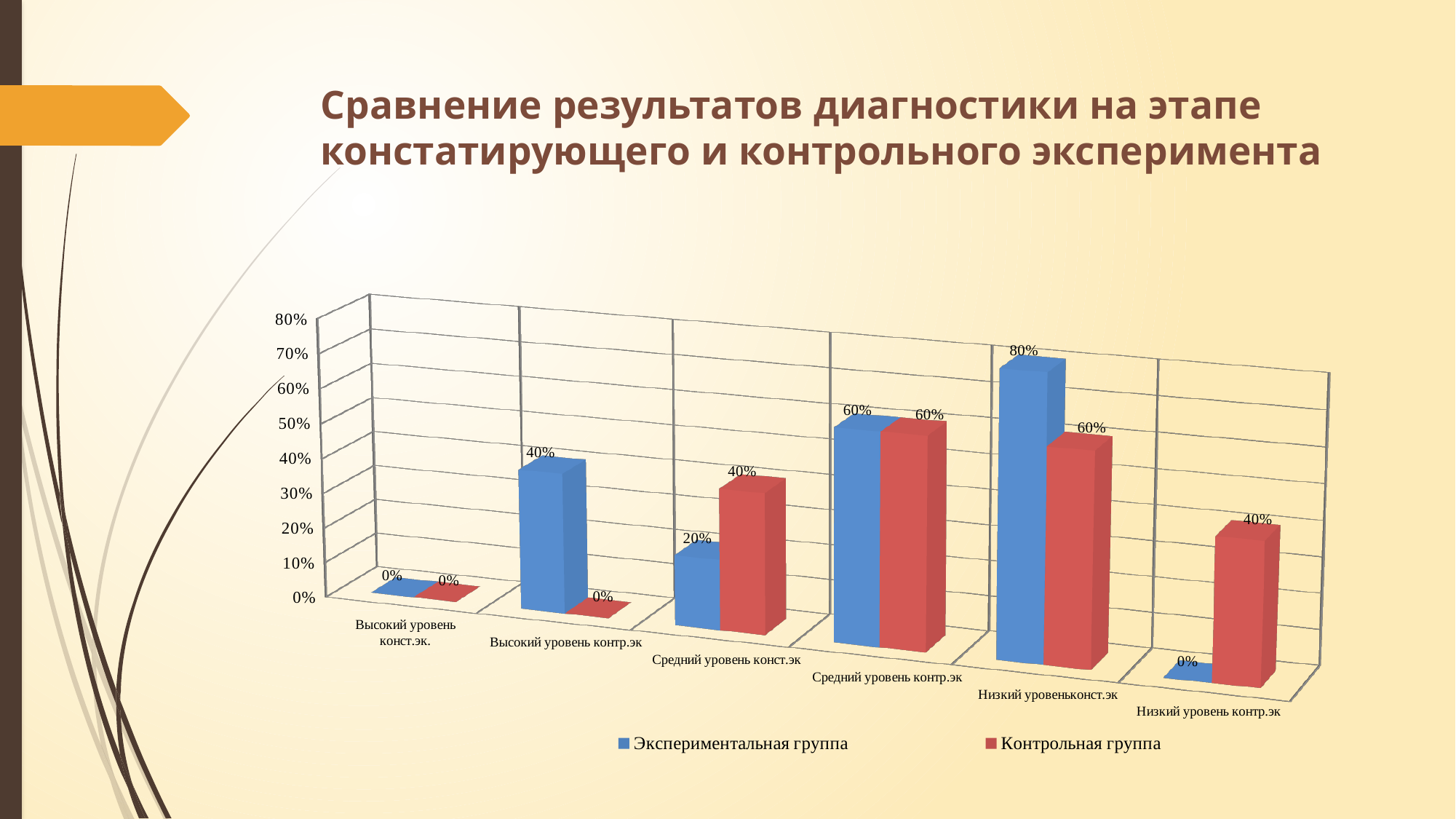
What is the value for Экспериментальная группа at Высокий уровень контр.эк? 40% How many categories are shown on the x axis? 6 What is the value for Контрольная группа at Средний уровень конст.эк? 40% What is the value for Экспериментальная группа at Средний уровень конст.эк? 20% What is the difference between Экспериментальная группа and Контрольная группа at Низкий уровень конст.эк? 20% Which category has the highest value for Экспериментальная группа? Низкий уровень конст.эк What is the value for Экспериментальная группа at Низкий уровень конст.эк? 80% What is the value for Контрольная группа at Низкий уровень контр.эк? 40% How many series does the legend list? 2 At Средний уровень конст.эк, which series has the larger value, Экспериментальная группа or Контрольная группа? Контрольная группа Which colour represents Контрольная группа in the chart? Red What kind of chart is shown on the slide? Bar chart